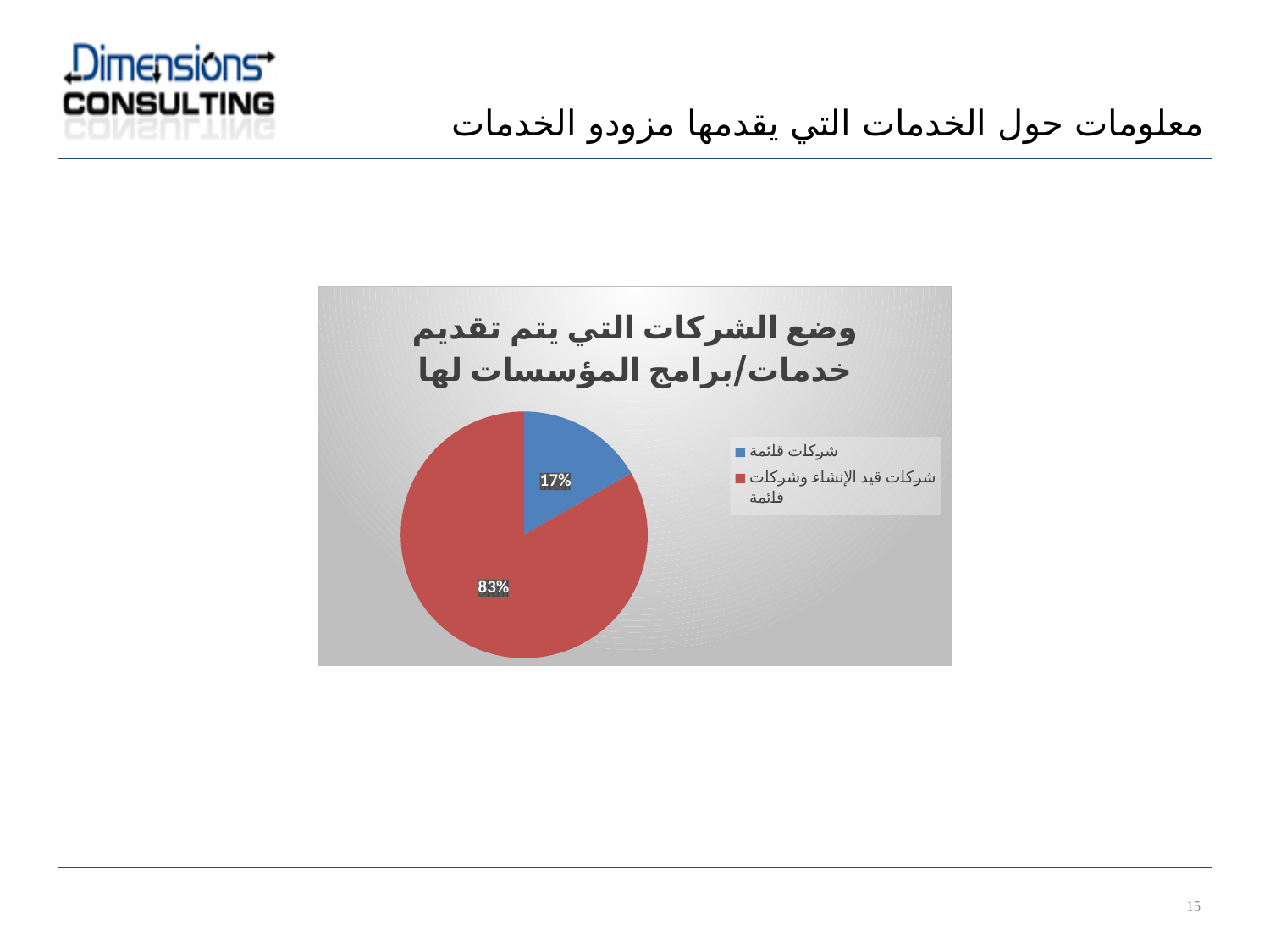
What colour is the slice for شركات قائمة? Blue What share of the pie does the slice for شركات قائمة represent? 17% Which category has the largest slice of the pie? شركات قيد الإنشاء وشركات قائمة How many slices does the pie chart have? 2 What is the difference in percentage points between the slice for شركات قيد الإنشاء وشركات قائمة and the slice for شركات قائمة? 66 What kind of chart is shown on the slide? Pie chart What share of the pie does the slice for شركات قيد الإنشاء وشركات قائمة represent? 83% How many entries does the legend list? 2 Which category has the smallest slice of the pie? شركات قائمة Which is larger: the slice for شركات قائمة or the slice for شركات قيد الإنشاء وشركات قائمة? شركات قيد الإنشاء وشركات قائمة What is the title of the pie chart? وضع الشركات التي يتم تقديم خدمات/برامج المؤسسات لها